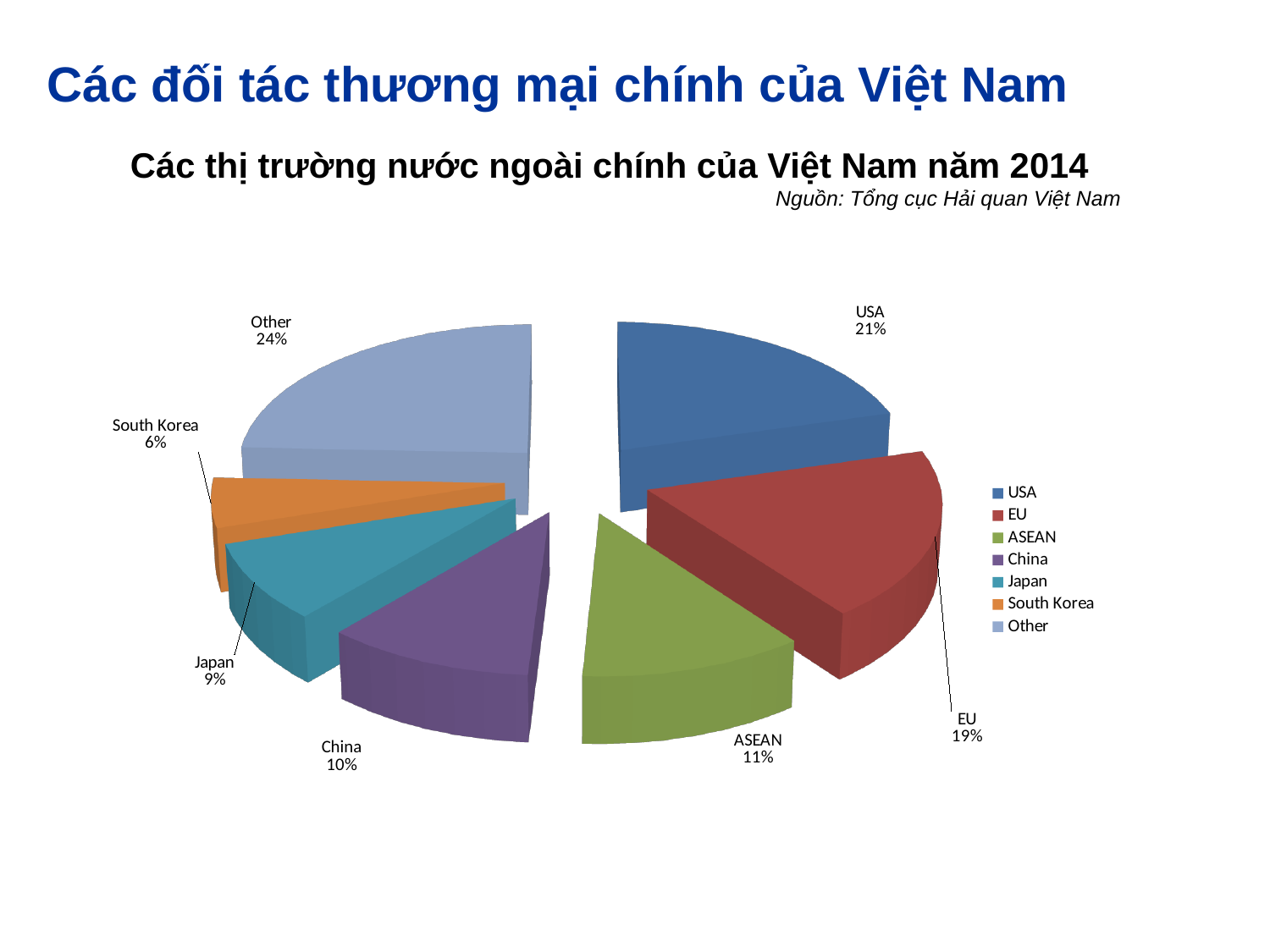
What share of the pie does EU hold? 19% What is the difference between the shares of Other and China? 14% How many slices does the pie chart have? 7 Which slice of the pie is the largest? Other What is the difference between the shares of USA and EU? 2% What share of the pie does Japan hold? 9% What share of the pie does South Korea hold? 6% Which slice of the pie is the smallest? South Korea What is the source cited for the chart? Tổng cục Hải quan Việt Nam What kind of chart is shown on the slide? Pie chart What share of the pie does USA hold? 21% Which has a larger share, ASEAN or China? ASEAN